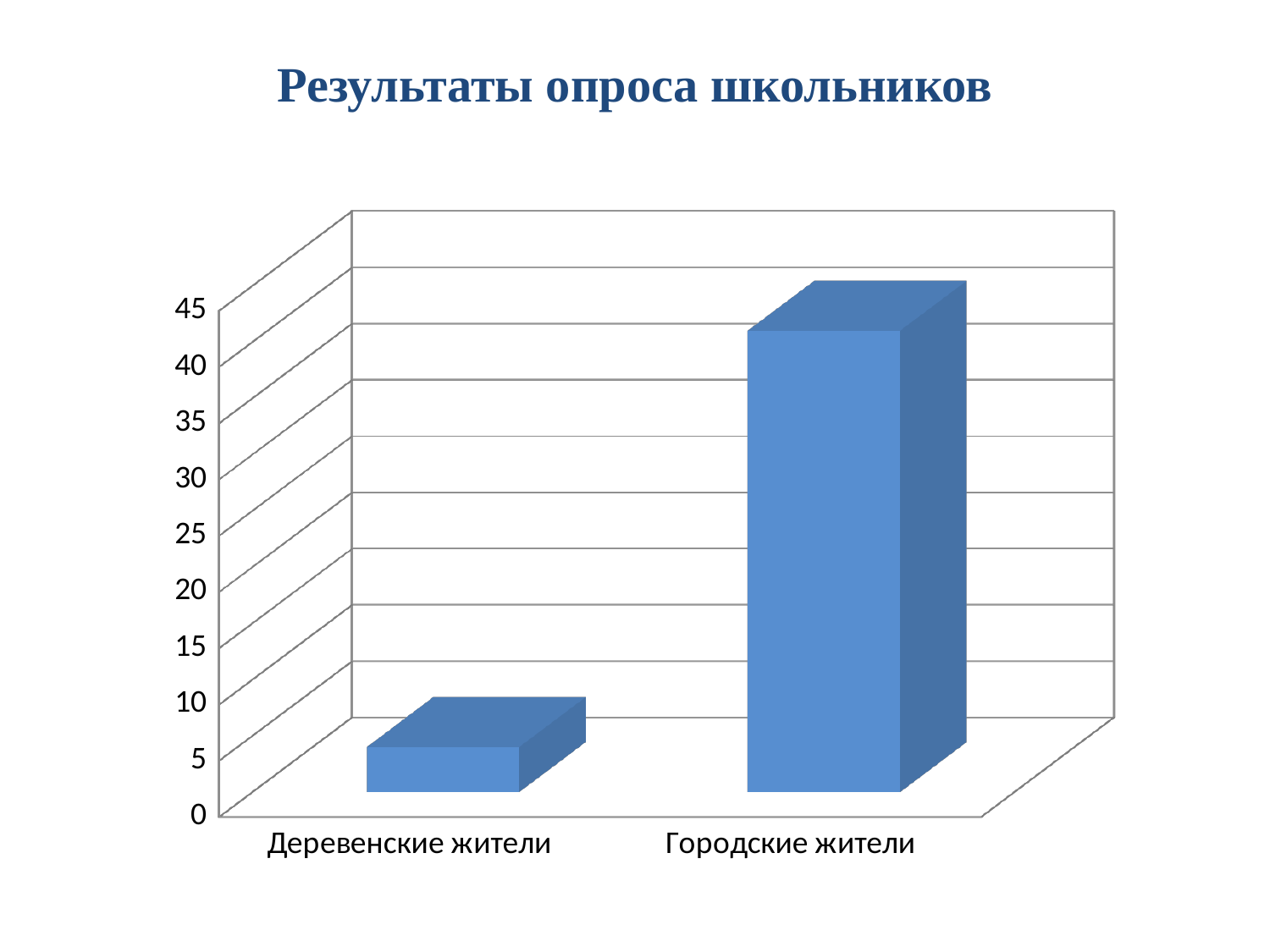
What kind of chart is shown on the slide? bar chart Which is larger, the value for Деревенские жители or the value for Городские жители? Городские жители What is the title of the slide above the chart? Результаты опроса школьников Which category has the highest bar? Городские жители What is the highest tick value labelled on the vertical axis? 45 Is the value for Городские жители greater or less than 35? greater Is the value for Деревенские жители greater or less than 20? less How many categories are shown on the x axis of the chart? 2 Is the value for Деревенские жители greater or less than 15? less Which category has the lowest bar? Деревенские жители